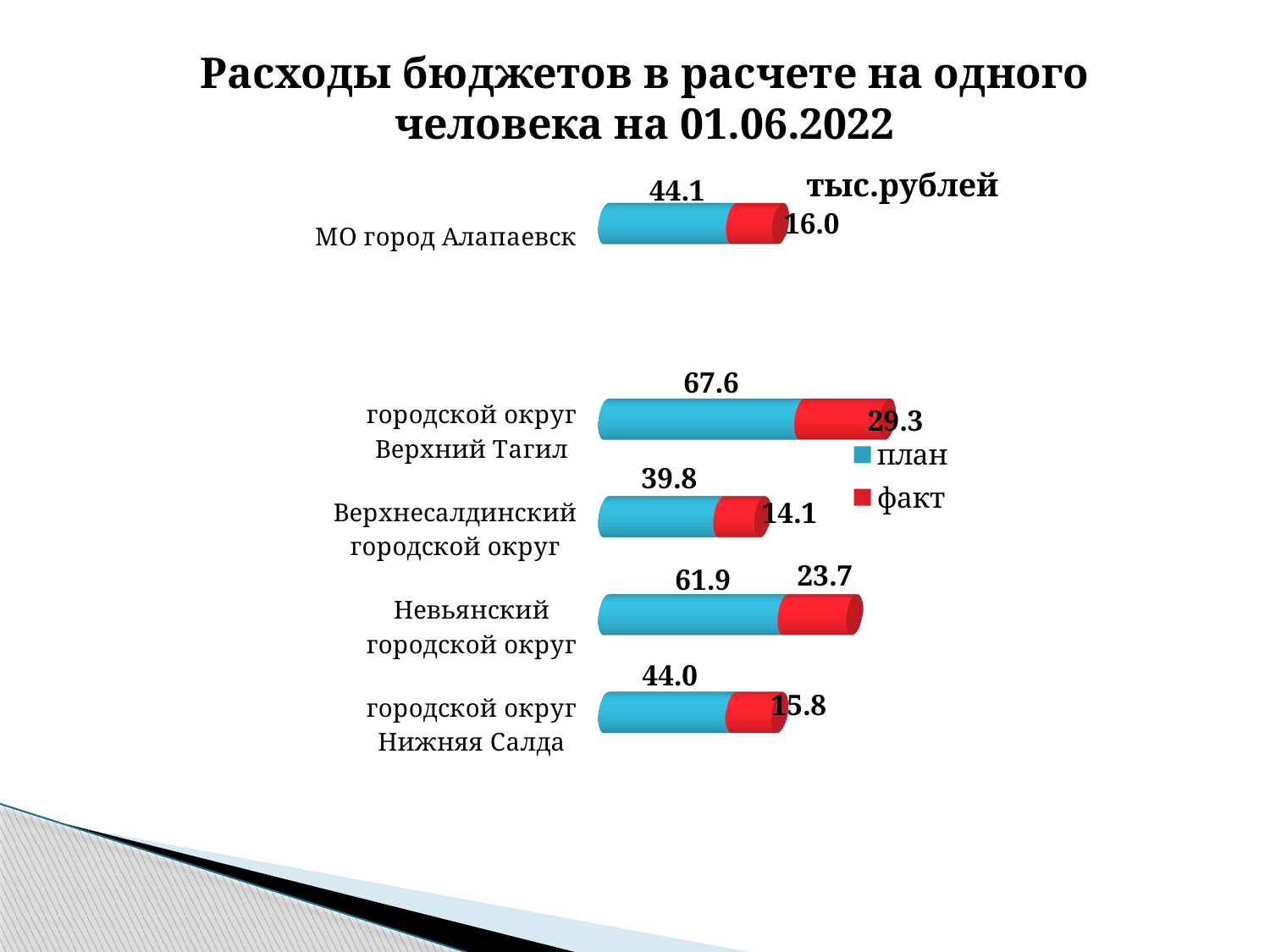
How many series does the legend list? 2 Which category has the highest план value? городской округ Верхний Тагил What unit is indicated for the values in the chart? тыс.рублей What kind of chart is shown on the slide? bar chart What is the план value for Верхнесалдинский городской округ? 39.8 What is the план value for городской округ Верхний Тагил? 67.6 What is the difference between the план and факт values for городской округ Нижняя Салда? 28.2 How many categories are shown in the chart? 5 Which category has the lowest факт value? Верхнесалдинский городской округ What is the факт value for МО город Алапаевск? 16.0 What is the факт value for Невьянский городской округ? 23.7 Which is larger: the факт value for городской округ Верхний Тагил or the факт value for Невьянский городской округ? городской округ Верхний Тагил